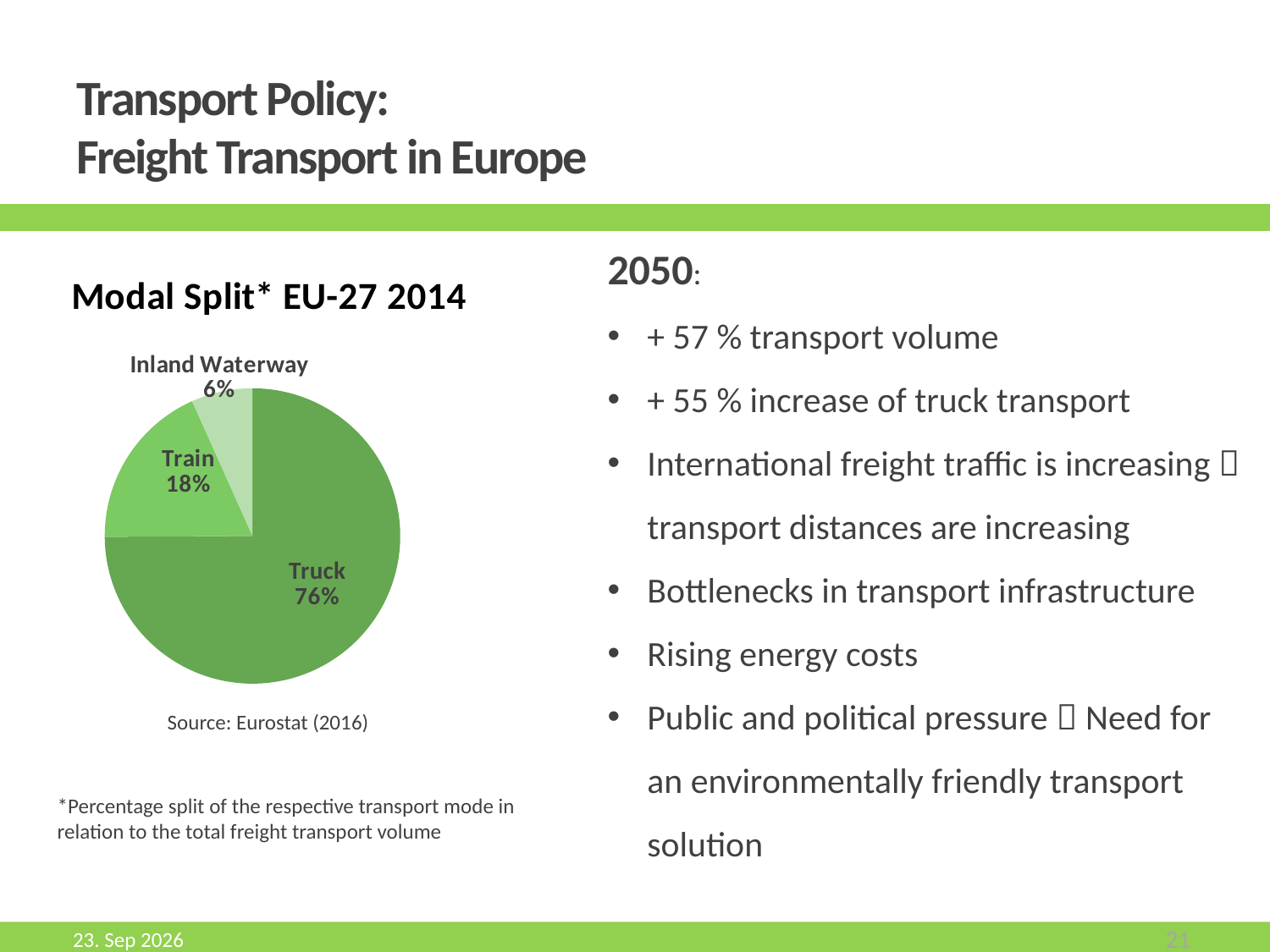
Which has a larger share, Train or Inland Waterway? Train What kind of chart is shown on the slide? Pie chart Which transport mode has the smallest share of the pie? Inland Waterway Which transport mode has the largest share of the pie? Truck What share of the pie does Train have? 18% What share of the pie does Truck have? 76% What is the difference in percentage points between the Truck share and the Train share? 58 What share of the pie does Inland Waterway have? 6% How many transport modes are shown in the pie chart? 3 What is the title of the chart? Modal Split* EU-27 2014 What source is cited below the chart? Eurostat (2016) What is the difference in percentage points between the Train share and the Inland Waterway share? 12